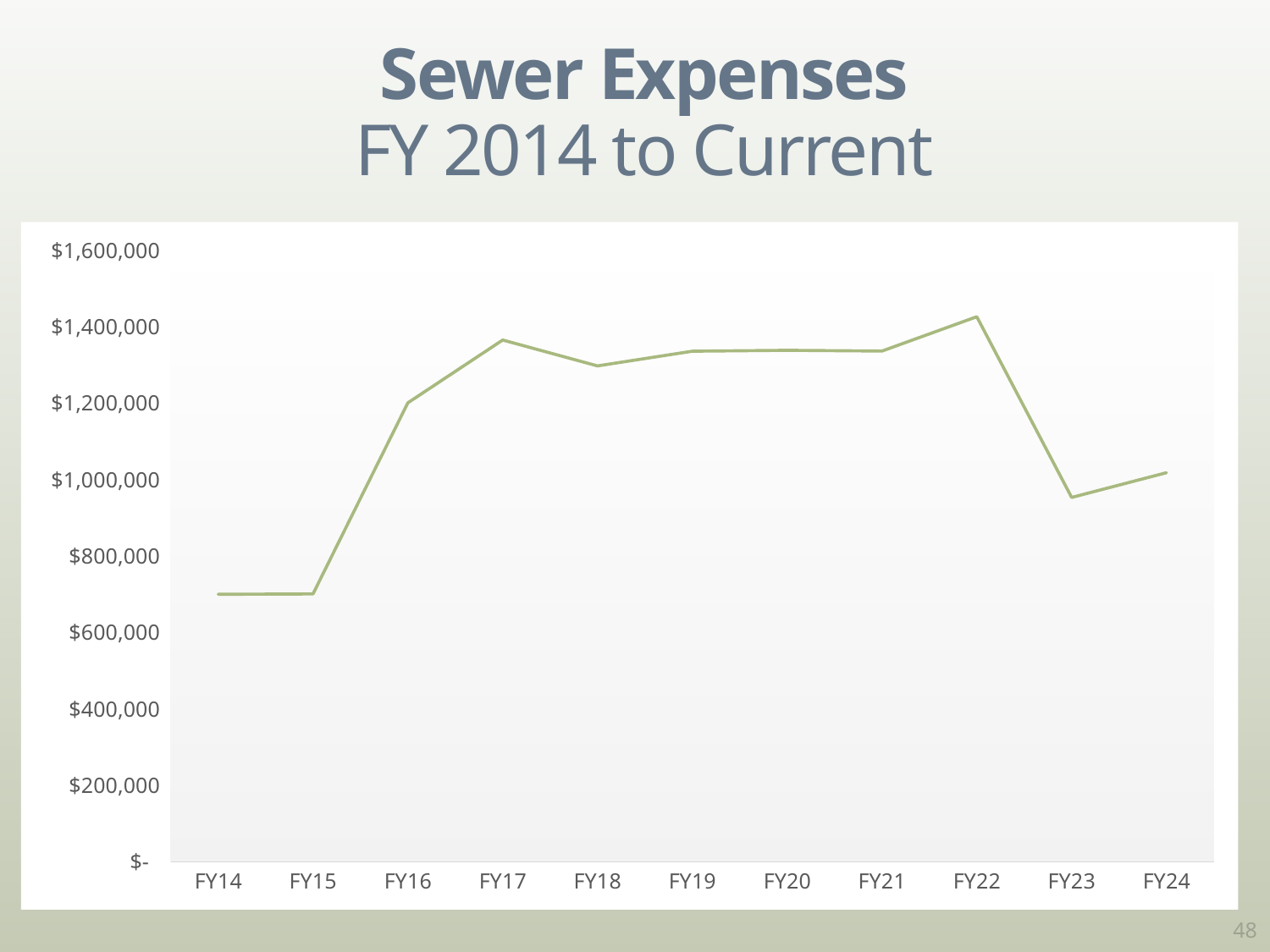
Do sewer expenses rise or fall from FY15 to FY17? rise Is the value for FY17 greater or less than $1,200,000? greater Which is larger, the value for FY16 or the value for FY23? FY16 Which fiscal year has the highest sewer expenses? FY22 What is the title of the chart on the slide? Sewer Expenses FY 2014 to Current Is the value for FY14 greater or less than $800,000? less Which is larger, the value for FY17 or the value for FY18? FY17 What kind of chart is shown on the slide? Line chart Is the value for FY16 greater or less than $1,000,000? greater How many fiscal years are plotted on the x axis? 11 Do sewer expenses rise or fall from FY22 to FY23? fall